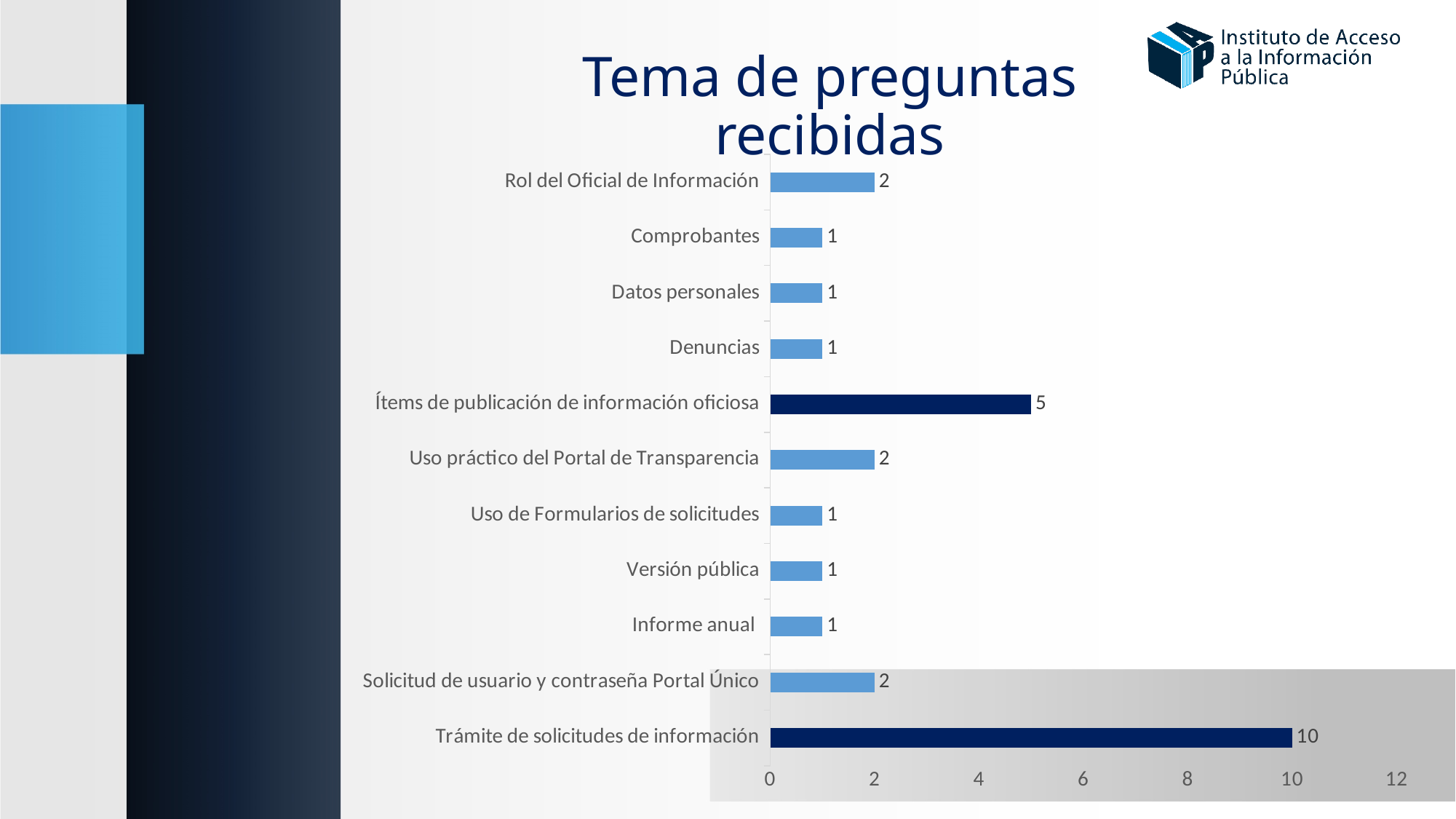
What is the value for Denuncias? 1 What is the value for Trámite de solicitudes de información? 10 What is the difference between Trámite de solicitudes de información and Ítems de publicación de información oficiosa? 5 Is the value for Trámite de solicitudes de información greater or less than 8? greater How many categories are shown in the chart? 11 Which is larger, Rol del Oficial de Información or Comprobantes? Rol del Oficial de Información What is the value for Ítems de publicación de información oficiosa? 5 What kind of chart is shown on the slide? Bar chart What is the value for Uso práctico del Portal de Transparencia? 2 How many categories have a value of 1? 6 Which category has the highest value? Trámite de solicitudes de información What is the title of the chart? Tema de preguntas recibidas